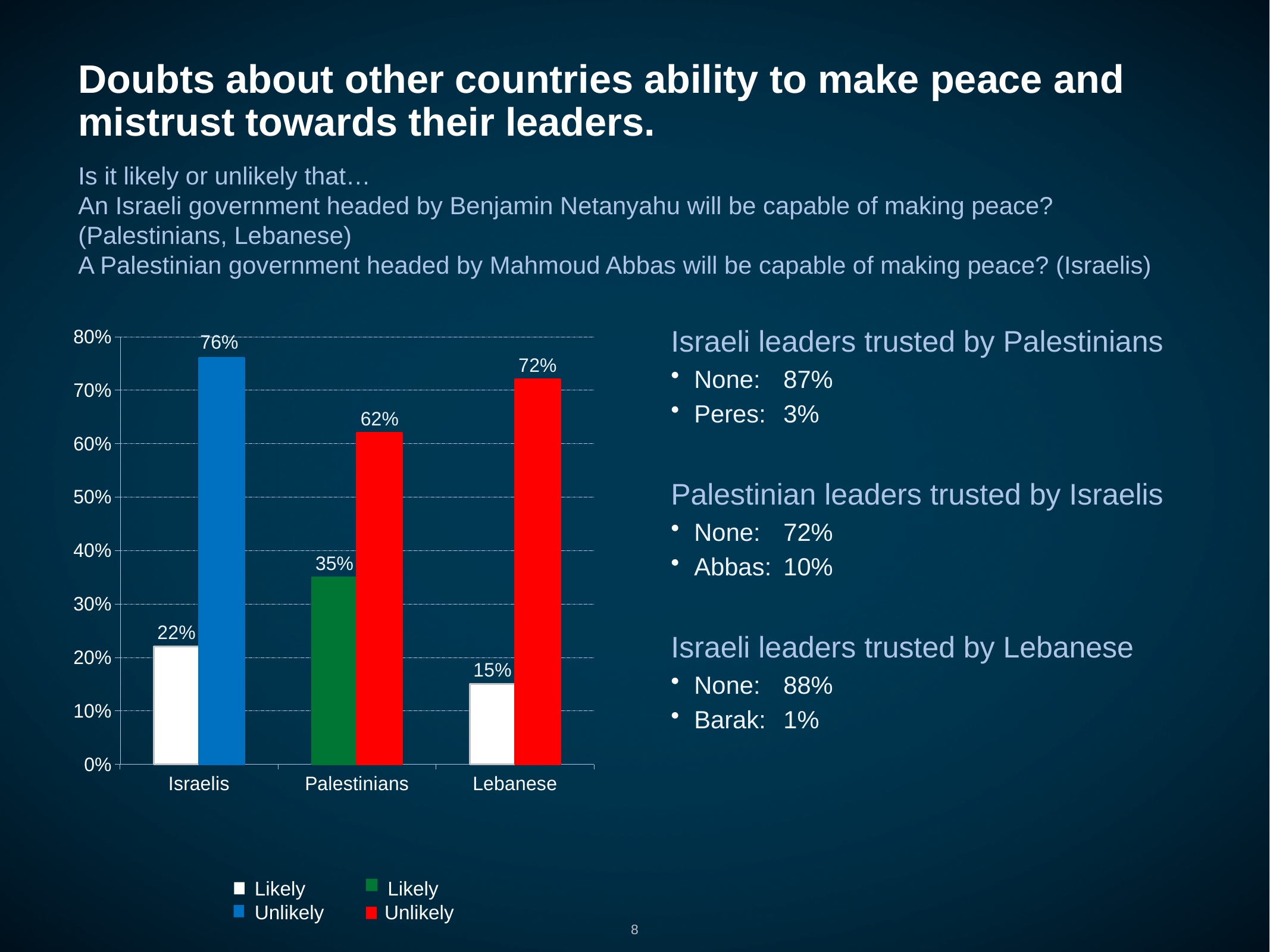
What is the difference between the Unlikely and Likely values for Israelis? 54% Which category has the highest Unlikely value? Israelis How many categories are shown on the x axis of the chart? 3 Which is larger, the Unlikely value for Palestinians or the Unlikely value for Lebanese? Unlikely value for Lebanese Which category has the lowest Likely value? Lebanese What is the Likely value for Lebanese? 15% What colour is the Unlikely bar for Israelis? blue What is the Unlikely value for Lebanese? 72% What is the Unlikely value for Israelis? 76% Is the Likely value for Israelis greater or less than 30%? less What is the Likely value for Palestinians? 35% What kind of chart is shown on the slide? bar chart